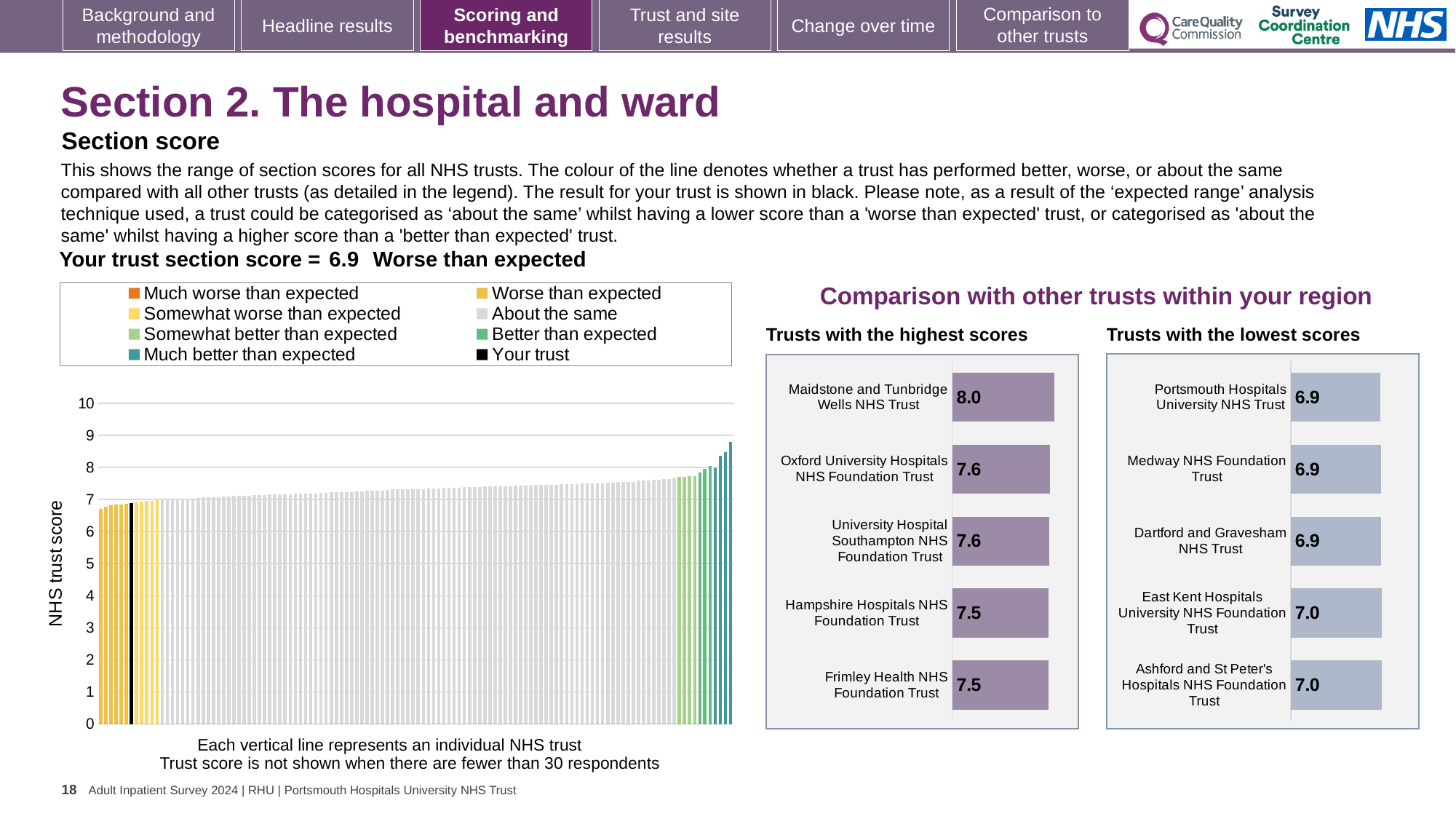
What type of chart is the large chart on the left showing all NHS trusts? bar chart In the 'Trusts with the highest scores' chart, what is the difference between the scores of Maidstone and Tunbridge Wells NHS Trust and Frimley Health NHS Foundation Trust? 0.5 Which is larger: the score for Oxford University Hospitals NHS Foundation Trust in the 'highest scores' chart or the score for Ashford and St Peter's Hospitals NHS Foundation Trust in the 'lowest scores' chart? Oxford University Hospitals NHS Foundation Trust In the 'Trusts with the highest scores' chart, which trust has the highest score? Maidstone and Tunbridge Wells NHS Trust How many trusts are listed in the 'Trusts with the lowest scores' chart? 5 In the large chart on the left showing all NHS trusts, do the bar values rise or fall from left to right? rise In the 'Trusts with the highest scores' chart, what is the score for Maidstone and Tunbridge Wells NHS Trust? 8.0 In the 'Trusts with the lowest scores' chart, what is the score for East Kent Hospitals University NHS Foundation Trust? 7.0 In the 'Trusts with the highest scores' chart, what is the score for Hampshire Hospitals NHS Foundation Trust? 7.5 In the 'Trusts with the lowest scores' chart, what is the difference between the scores of East Kent Hospitals University NHS Foundation Trust and Portsmouth Hospitals University NHS Trust? 0.1 In the large chart on the left showing all NHS trusts, is the value of the tallest bar greater or less than 8? greater How many entries does the legend of the large chart on the left list? 8